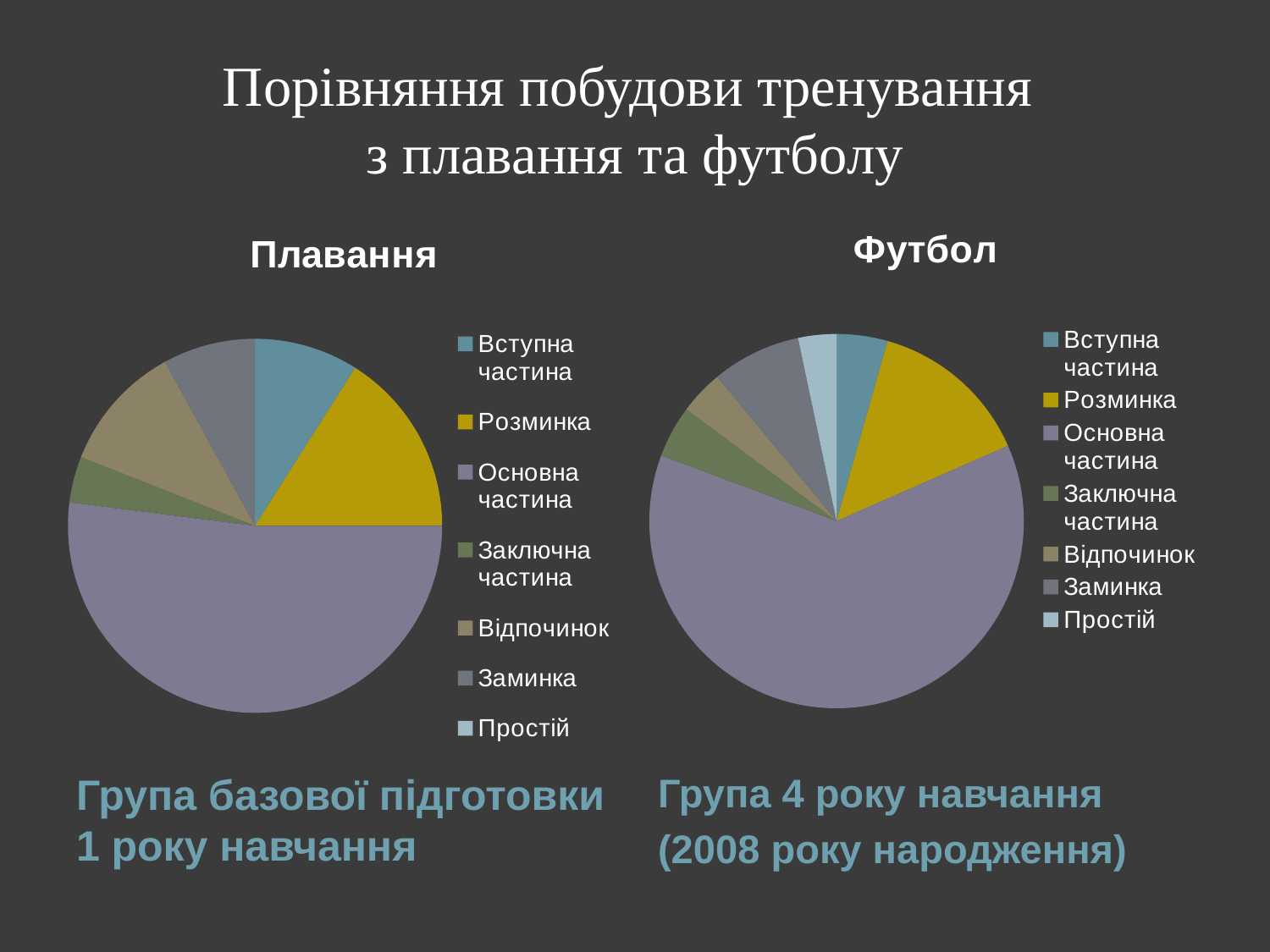
In the "Плавання" chart, which category has the largest slice? Основна частина In the "Футбол" chart, which slice is larger: Основна частина or Розминка? Основна частина What kind of chart is the "Футбол" chart? pie chart How many pie charts are shown on the slide? 2 In the "Плавання" chart, which slice is larger: Розминка or Вступна частина? Розминка What kind of chart is the "Плавання" chart? pie chart What is the title of the pie chart on the right side of the slide? Футбол In the "Футбол" chart, which slice is larger: Розминка or Вступна частина? Розминка How many entries does the legend of the "Плавання" chart list? 7 How many entries does the legend of the "Футбол" chart list? 7 In the "Футбол" chart, which category has the largest slice? Основна частина